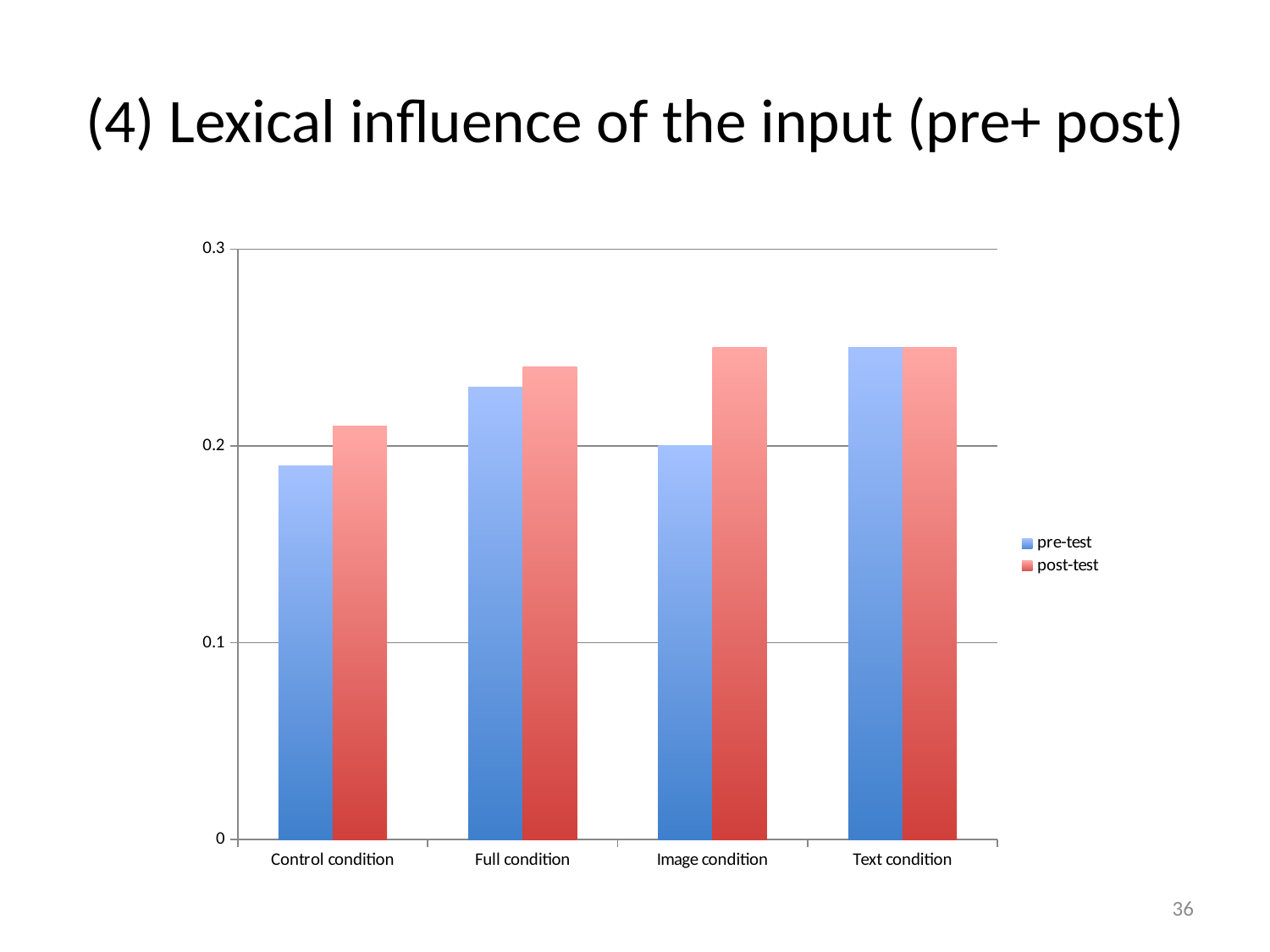
What kind of chart is shown on the slide? bar chart Which condition has the lowest pre-test value? Control condition Is the post-test value for the Control condition greater or less than 0.2? greater How many series does the chart's legend list? 2 Is the pre-test value for the Control condition greater or less than 0.2? less Which condition has the lowest post-test value? Control condition How many conditions are shown on the x axis of the chart? 4 Which condition has the highest pre-test value? Text condition What are the two series named in the legend? pre-test and post-test For the Image condition, which is larger: the pre-test value or the post-test value? post-test Is the post-test value for the Image condition greater or less than 0.3? less For the Control condition, which is larger: the pre-test value or the post-test value? post-test